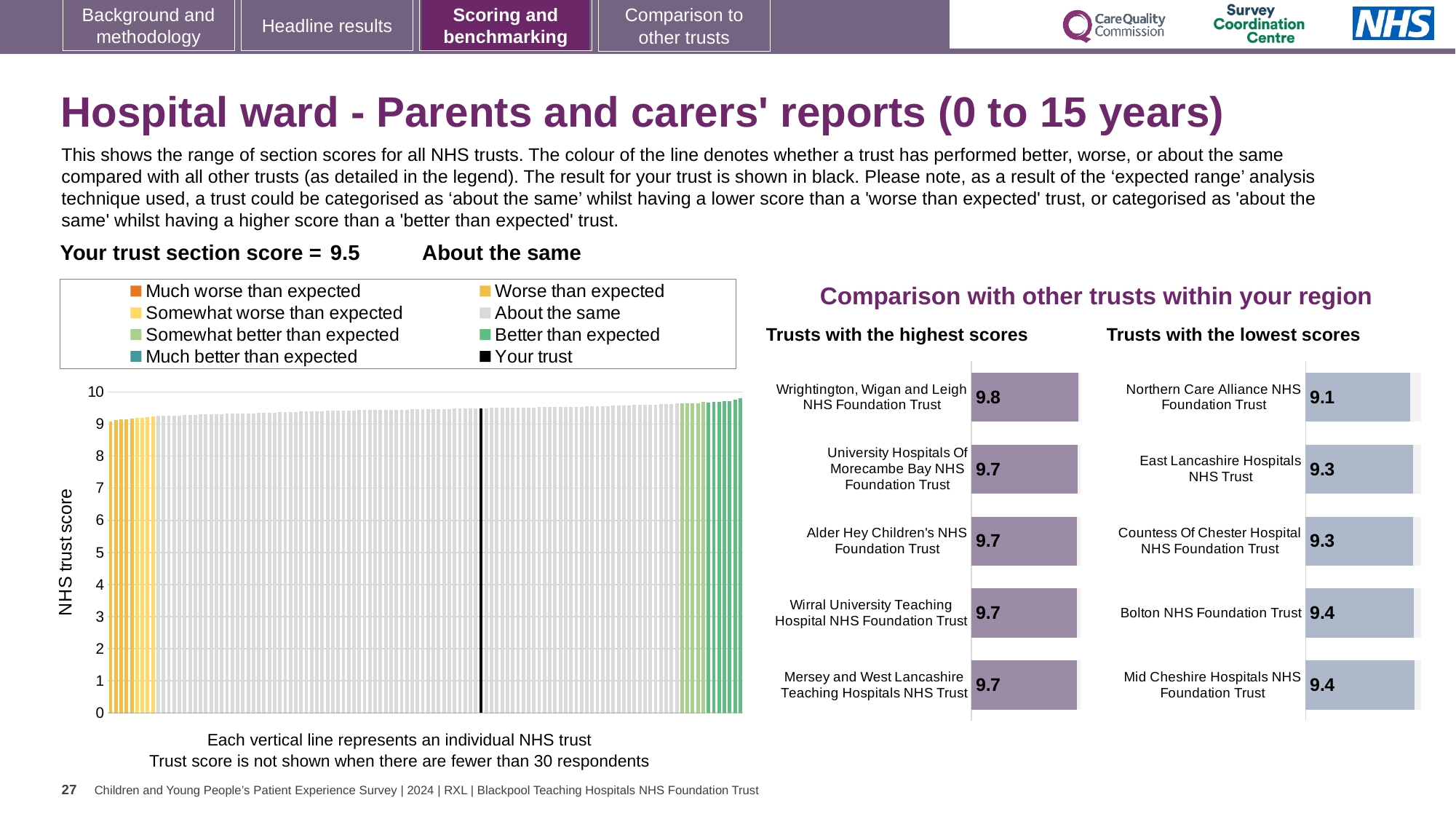
In the 'Trusts with the lowest scores' chart, what is the difference between the scores of Bolton NHS Foundation Trust and Northern Care Alliance NHS Foundation Trust? 0.3 In the 'Trusts with the lowest scores' chart, what is the score for Northern Care Alliance NHS Foundation Trust? 9.1 How many entries does the legend of the large chart on the left list? 8 In the large chart on the left showing all NHS trusts, is the value of the tallest bar greater or less than 9? greater In the 'Trusts with the lowest scores' chart, what is the score for Bolton NHS Foundation Trust? 9.4 In the 'Trusts with the highest scores' chart, which trust has the highest score? Wrightington, Wigan and Leigh NHS Foundation Trust In the 'Trusts with the lowest scores' chart, which trust has the lowest score? Northern Care Alliance NHS Foundation Trust In the 'Trusts with the highest scores' chart, which has the larger score: Wrightington, Wigan and Leigh NHS Foundation Trust or Alder Hey Children's NHS Foundation Trust? Wrightington, Wigan and Leigh NHS Foundation Trust How many trusts are listed in the 'Trusts with the lowest scores' chart? 5 In the large chart on the left showing all NHS trusts, do the bar values rise or fall from left to right along the x axis? Rise In the 'Trusts with the highest scores' chart, what is the score for Wrightington, Wigan and Leigh NHS Foundation Trust? 9.8 What kind of chart is the 'Trusts with the highest scores' chart? Bar chart